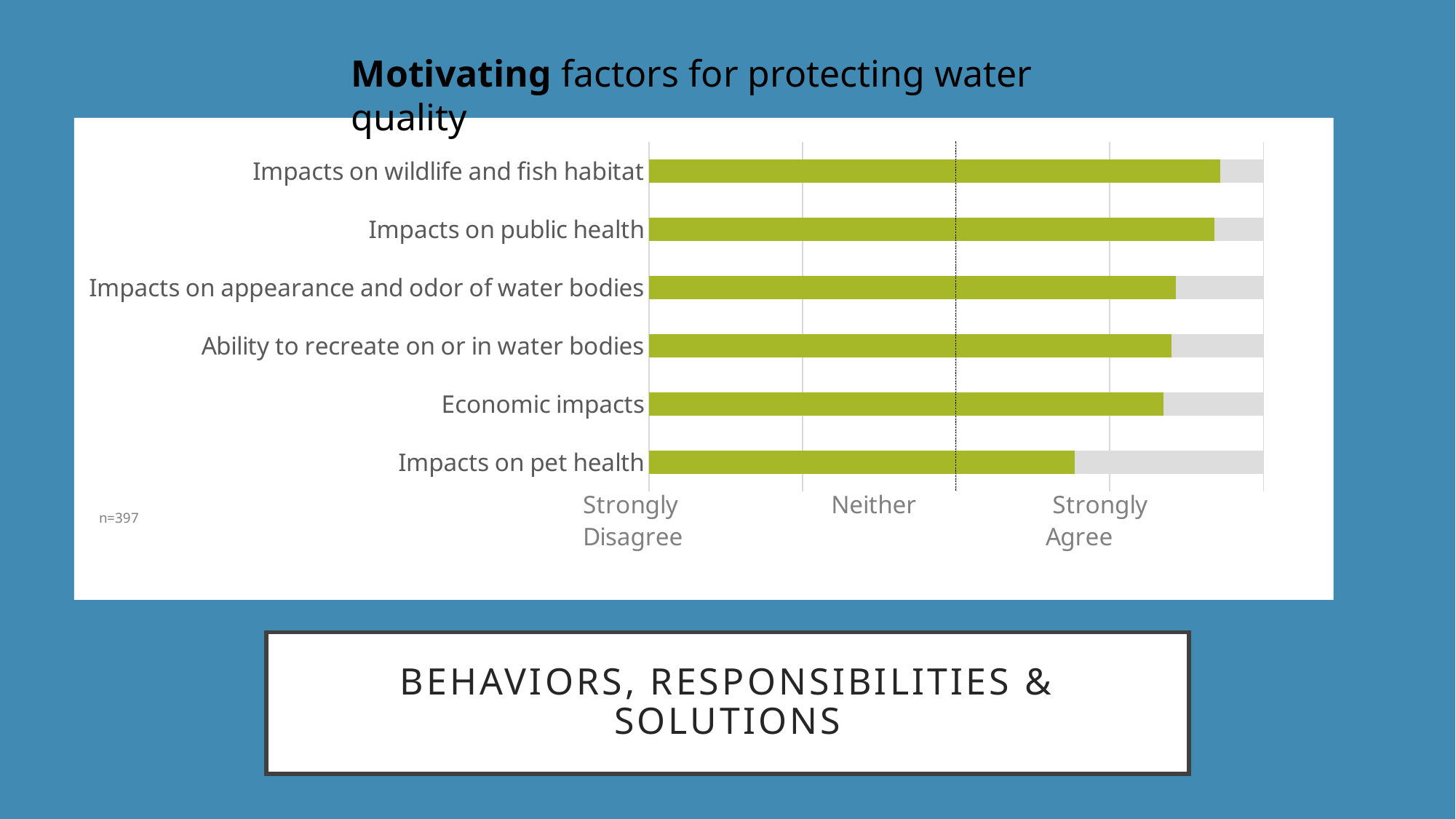
Which motivating factor has the lowest level of agreement in the chart? Impacts on pet health Which has a higher level of agreement: Impacts on appearance and odor of water bodies or Impacts on pet health? Impacts on appearance and odor of water bodies Does the bar for Economic impacts extend past the Strongly Agree mark on the axis? yes How many motivating factors (categories) are plotted in the chart? 6 Which has a higher level of agreement: Impacts on wildlife and fish habitat or Impacts on pet health? Impacts on wildlife and fish habitat What is the title of the chart? Motivating factors for protecting water quality Which has a higher level of agreement: Impacts on public health or Economic impacts? Impacts on public health What sample size (n) is noted on the chart? n=397 Which category is listed at the top of the chart? Impacts on wildlife and fish habitat What kind of chart is shown on the slide? bar chart Does the bar for Impacts on pet health extend past the Neither mark on the axis? yes